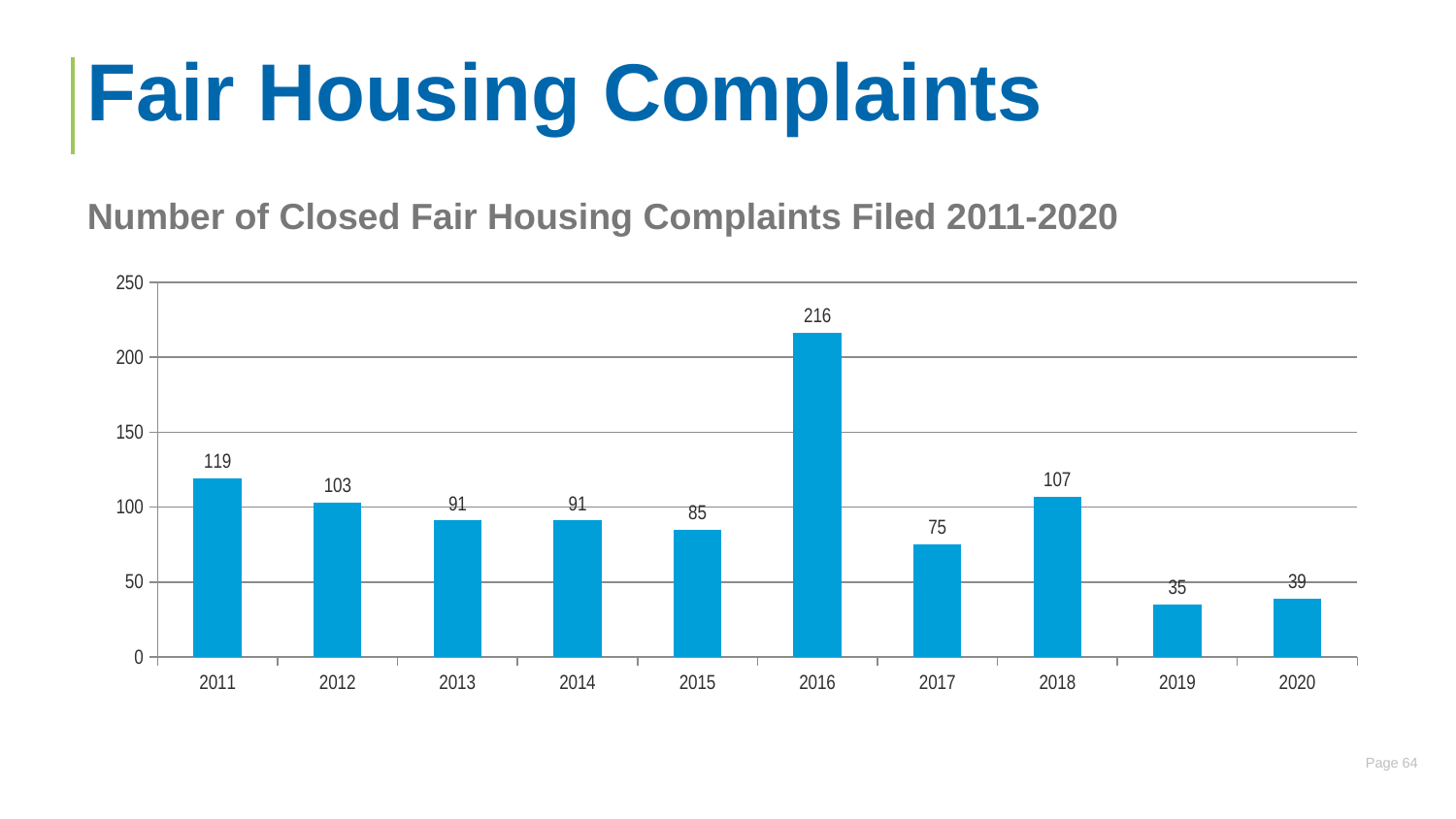
Which year has the lowest number of closed fair housing complaints? 2019 What is the number of closed fair housing complaints in 2019? 35 Which year had more closed complaints, 2011 or 2018? 2011 What kind of chart is shown on the slide? Bar chart What is the number of closed fair housing complaints in 2012? 103 What is the subtitle describing the chart on the slide? Number of Closed Fair Housing Complaints Filed 2011-2020 Do the values rise or fall from 2016 to 2017? Fall How many years are shown on the x axis of the chart? 10 Which year has the highest number of closed fair housing complaints? 2016 What is the difference between the number of complaints in 2016 and 2017? 141 Is the value for 2015 greater or less than 100? less What is the number of closed fair housing complaints in 2016? 216